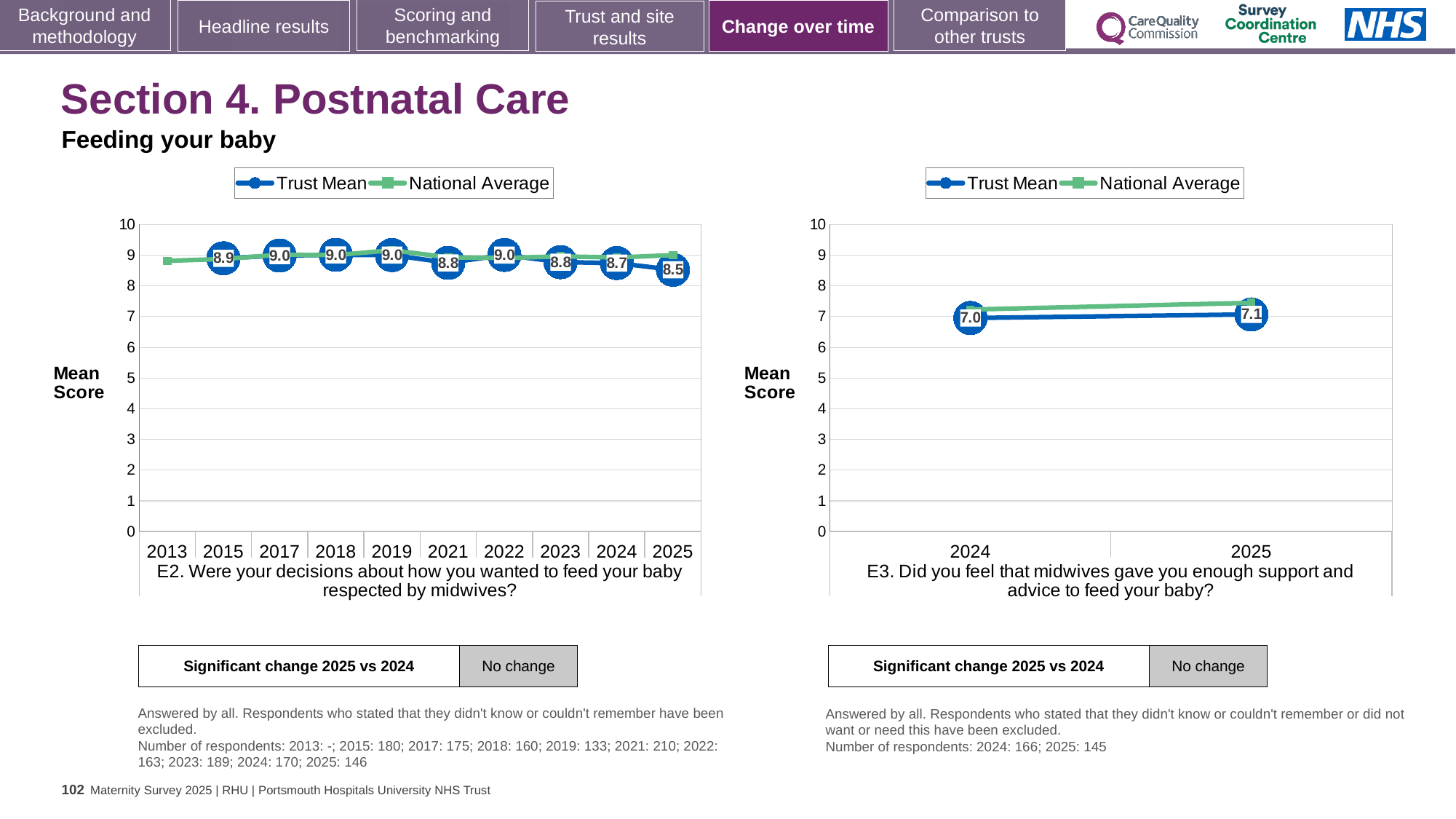
In the left chart (E2), what is the Trust Mean for 2025? 8.5 In the left chart (E2), how many years are shown on the x axis? 10 In the left chart (E2), what is the difference between the Trust Mean for 2024 and 2025? 0.2 In the right chart (E3), is the Trust Mean higher in 2024 or 2025? 2025 In the right chart (E3), what is the Trust Mean for 2024? 7.0 In the right chart (E3), is the National Average for 2025 greater or less than 5? greater In the left chart (E2), does the Trust Mean rise or fall from 2022 to 2025? Fall In the right chart (E3), what is the Trust Mean for 2025? 7.1 In the left chart (E2), which year has the lowest Trust Mean? 2025 In the left chart (E2), what is the Trust Mean for 2015? 8.9 What kind of chart is the right chart (E3)? Line chart In the left chart (E2), how many series does the legend list? 2